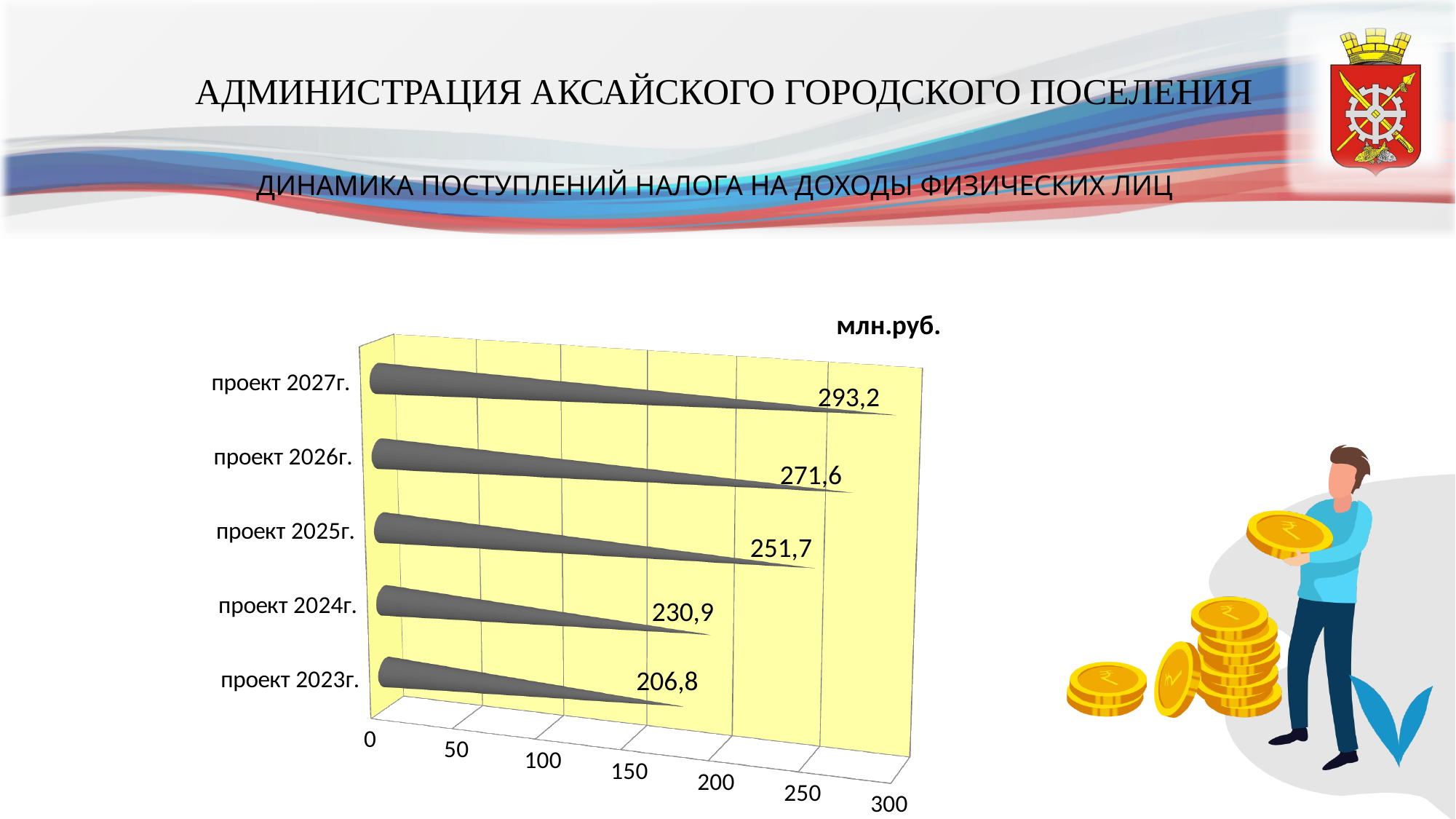
What is the value for проект 2025г.? 251,7 Which is larger, the value for проект 2024г. or проект 2026г.? проект 2026г. What is the difference between the values for проект 2027г. and проект 2023г.? 86,4 How many categories are shown in the chart? 5 What is the difference between the values for проект 2026г. and проект 2025г.? 19,9 What unit is indicated above the chart? млн.руб. What kind of chart is shown on the slide? bar chart Which category has the highest value? проект 2027г. Which category has the lowest value? проект 2023г. Is the value for проект 2024г. greater or less than 200? greater What is the value for проект 2023г.? 206,8 What is the value for проект 2027г.? 293,2